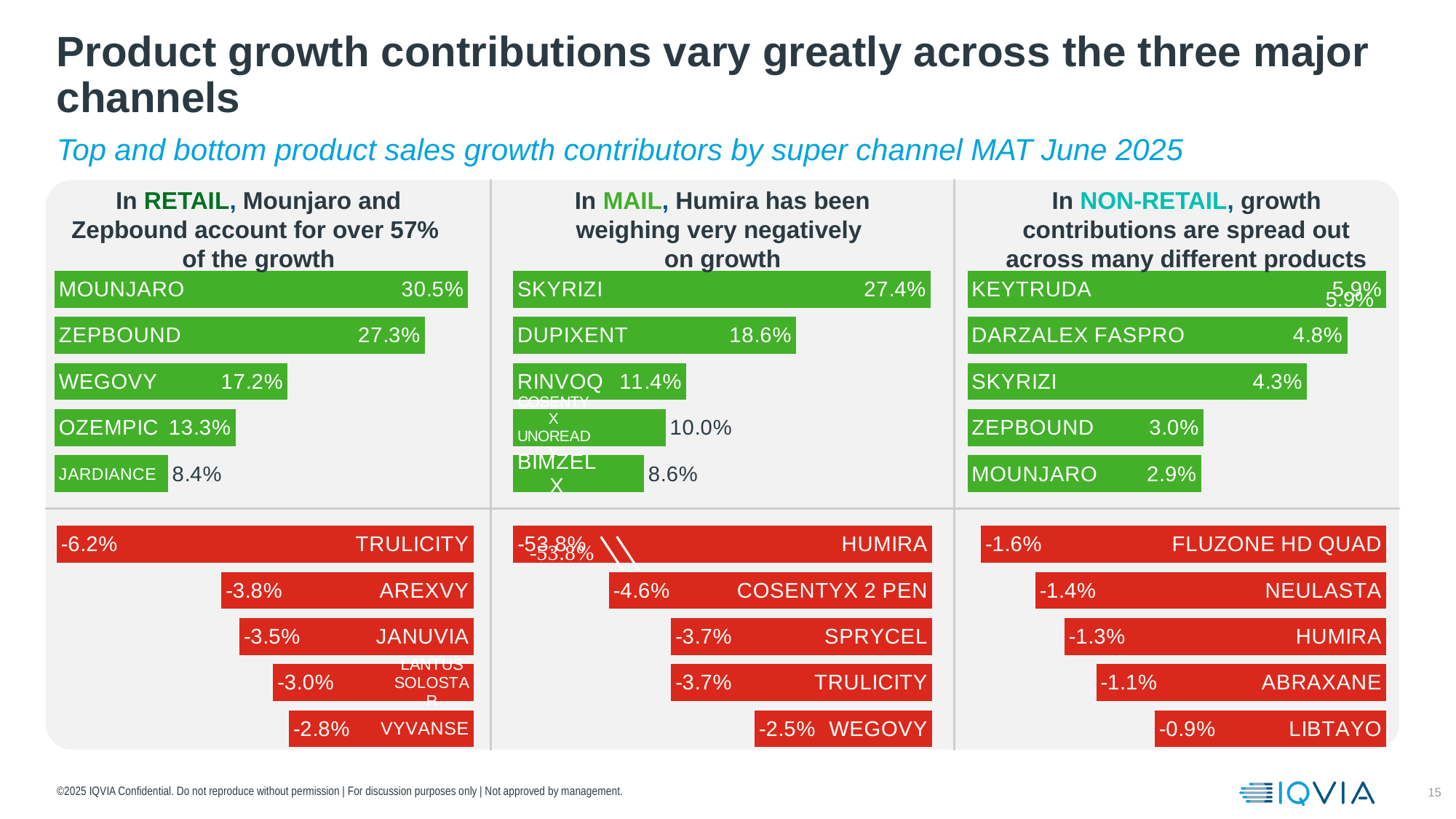
In the NON-RETAIL chart, what is the growth contribution for LIBTAYO? -0.9% In the NON-RETAIL chart, what is the growth contribution for DARZALEX FASPRO? 4.8% In the RETAIL chart, what is the growth contribution for TRULICITY? -6.2% In the RETAIL chart, which product has the highest growth contribution? MOUNJARO What type of chart is used to show the product growth contributions on this slide? Bar chart In the MAIL chart, what is the growth contribution for HUMIRA? -53.8% In the NON-RETAIL chart, which has the larger growth contribution, SKYRIZI or ZEPBOUND? SKYRIZI In the RETAIL chart, what is the growth contribution for MOUNJARO? 30.5% How many products are shown with positive growth contributions in the NON-RETAIL chart? 5 In the MAIL chart, which product has the lowest (most negative) growth contribution? HUMIRA In the MAIL chart, what is the growth contribution for DUPIXENT? 18.6% In the RETAIL chart, what is the difference between the contributions of MOUNJARO and ZEPBOUND? 3.2%